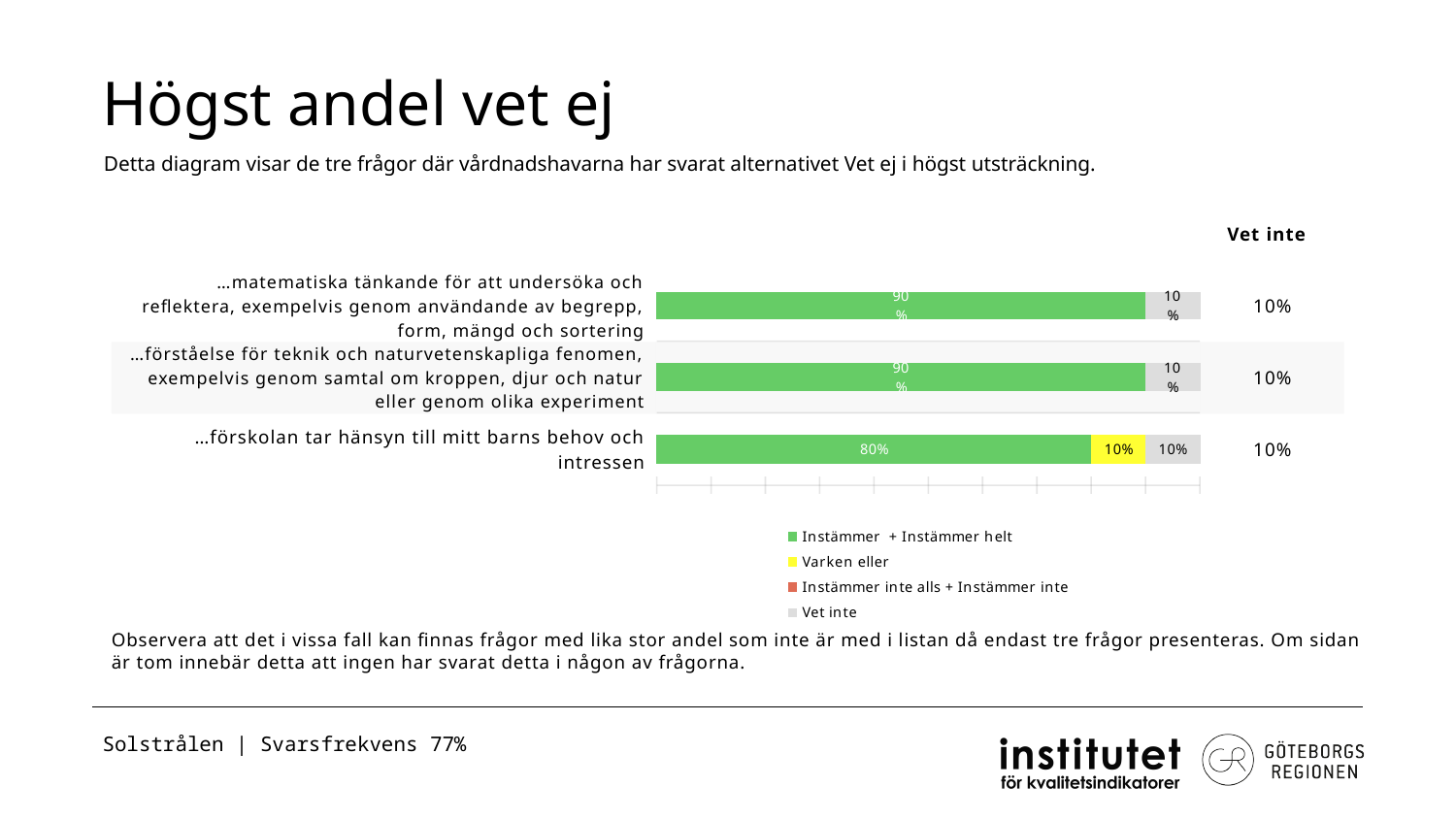
What is the 'Vet inte' value shown for '…förståelse för teknik och naturvetenskapliga fenomen, exempelvis genom samtal om kroppen, djur och natur eller genom olika experiment'? 10% What kind of chart is shown on the slide? bar chart What is the difference between the 'Instämmer + Instämmer helt' value for '…matematiska tänkande…' and for '…förskolan tar hänsyn till mitt barns behov och intressen'? 10% Which category has the lowest 'Instämmer + Instämmer helt' value? …förskolan tar hänsyn till mitt barns behov och intressen What is the value of 'Instämmer + Instämmer helt' for '…matematiska tänkande för att undersöka och reflektera, exempelvis genom användande av begrepp, form, mängd och sortering'? 90% How many series does the chart legend list? 4 What is the value of 'Varken eller' for '…förskolan tar hänsyn till mitt barns behov och intressen'? 10% Which is larger: the 'Instämmer + Instämmer helt' value for '…förståelse för teknik och naturvetenskapliga fenomen…' or for '…förskolan tar hänsyn till mitt barns behov och intressen'? …förståelse för teknik och naturvetenskapliga fenomen… Which legend entry is shown in yellow? Varken eller What is the total of the stacked bar for '…förskolan tar hänsyn till mitt barns behov och intressen'? 100% How many categories (questions) are plotted in the chart? 3 What is the value of 'Instämmer + Instämmer helt' for '…förskolan tar hänsyn till mitt barns behov och intressen'? 80%